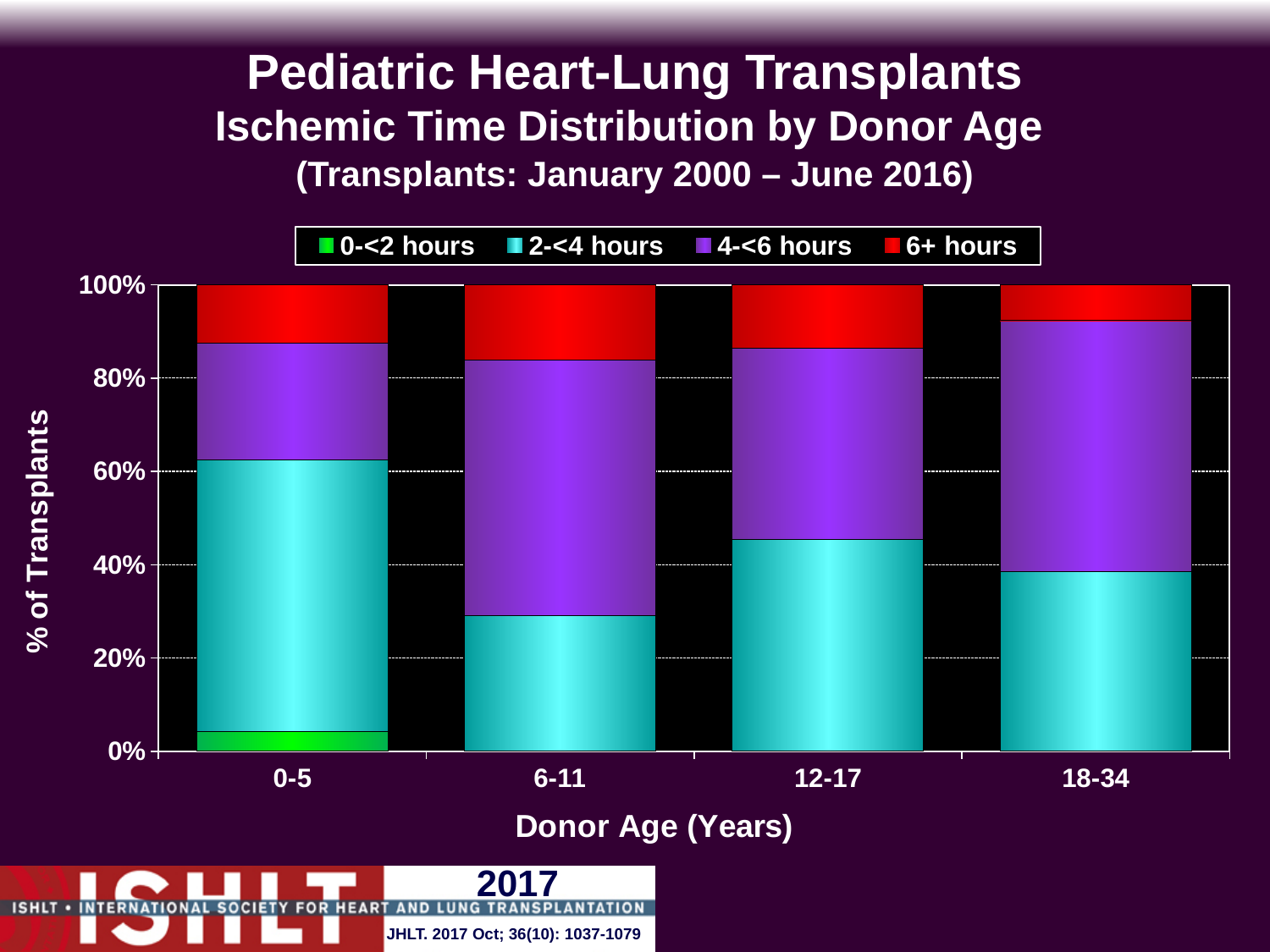
Which donor age group has a larger share of 2-<4 hours transplants, 0-5 or 6-11? 0-5 What is the label of the y axis? % of Transplants Which donor age group is the only one with a visible 0-<2 hours segment? 0-5 Which donor age group has the smallest share of transplants with 6+ hours ischemic time? 18-34 What kind of chart is shown on the slide? Stacked bar chart Which donor age group has the largest share of transplants with 2-<4 hours ischemic time? 0-5 How many series does the legend list? 4 Is the share of 2-<4 hours transplants for donor age 12-17 greater or less than 40%? greater Which donor age group has the smallest share of transplants with 4-<6 hours ischemic time? 0-5 Which ischemic time category is shown in red in the legend? 6+ hours How many donor age groups are shown on the x axis? 4 Is the share of 2-<4 hours transplants for donor age 6-11 greater or less than 40%? less